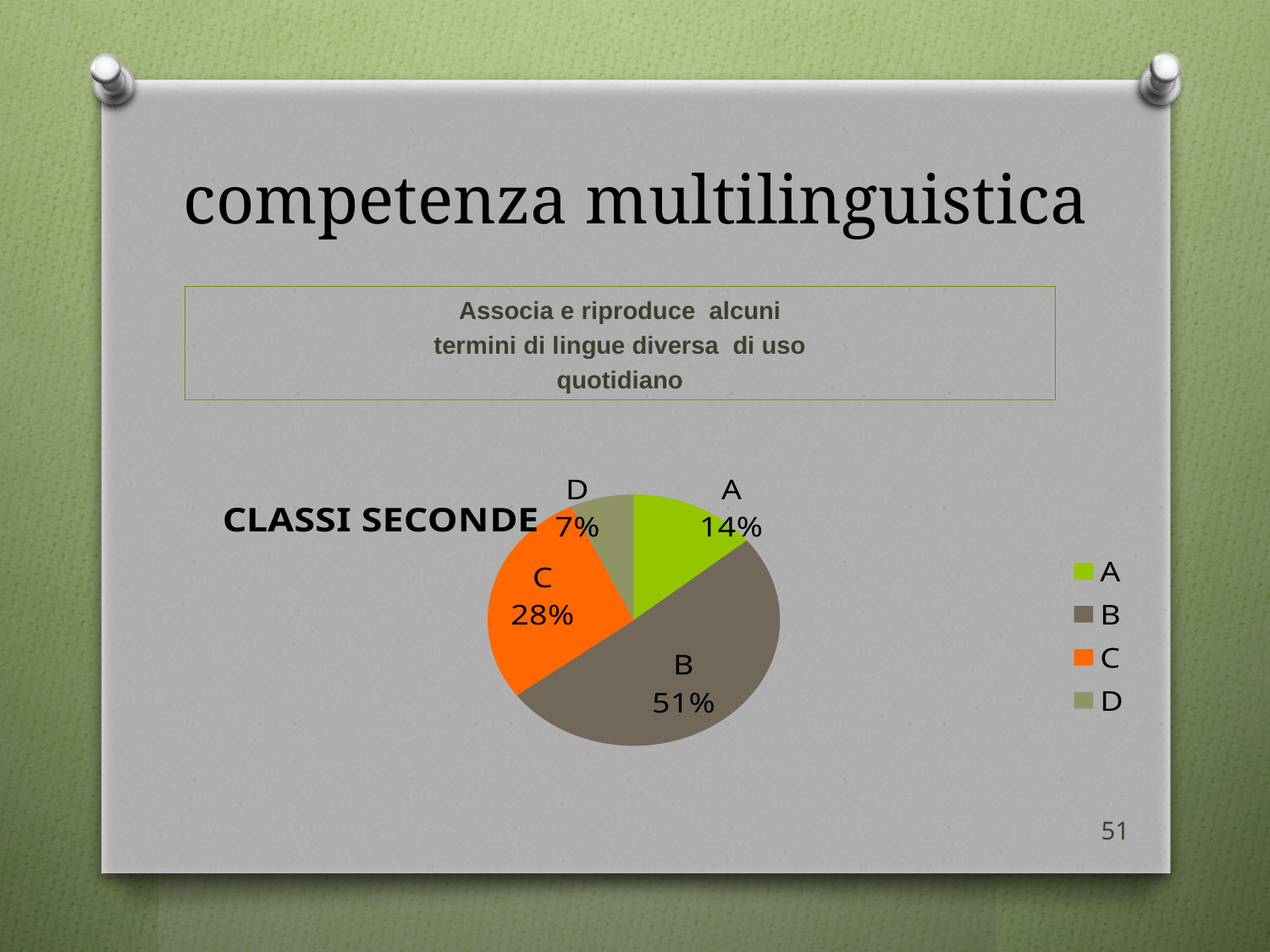
What percentage does slice B represent? 51% Which is larger, the share for A or the share for C? C What is the title of the chart? CLASSI SECONDE What percentage does slice C represent? 28% Which category has the smallest share of the pie? D What kind of chart is shown on the slide? pie chart What percentage does slice D represent? 7% How many categories does the pie chart have? 4 What percentage does slice A represent? 14% What colour is the slice for C in the legend? orange Which category has the largest share of the pie? B What is the difference in percentage points between B and C? 23